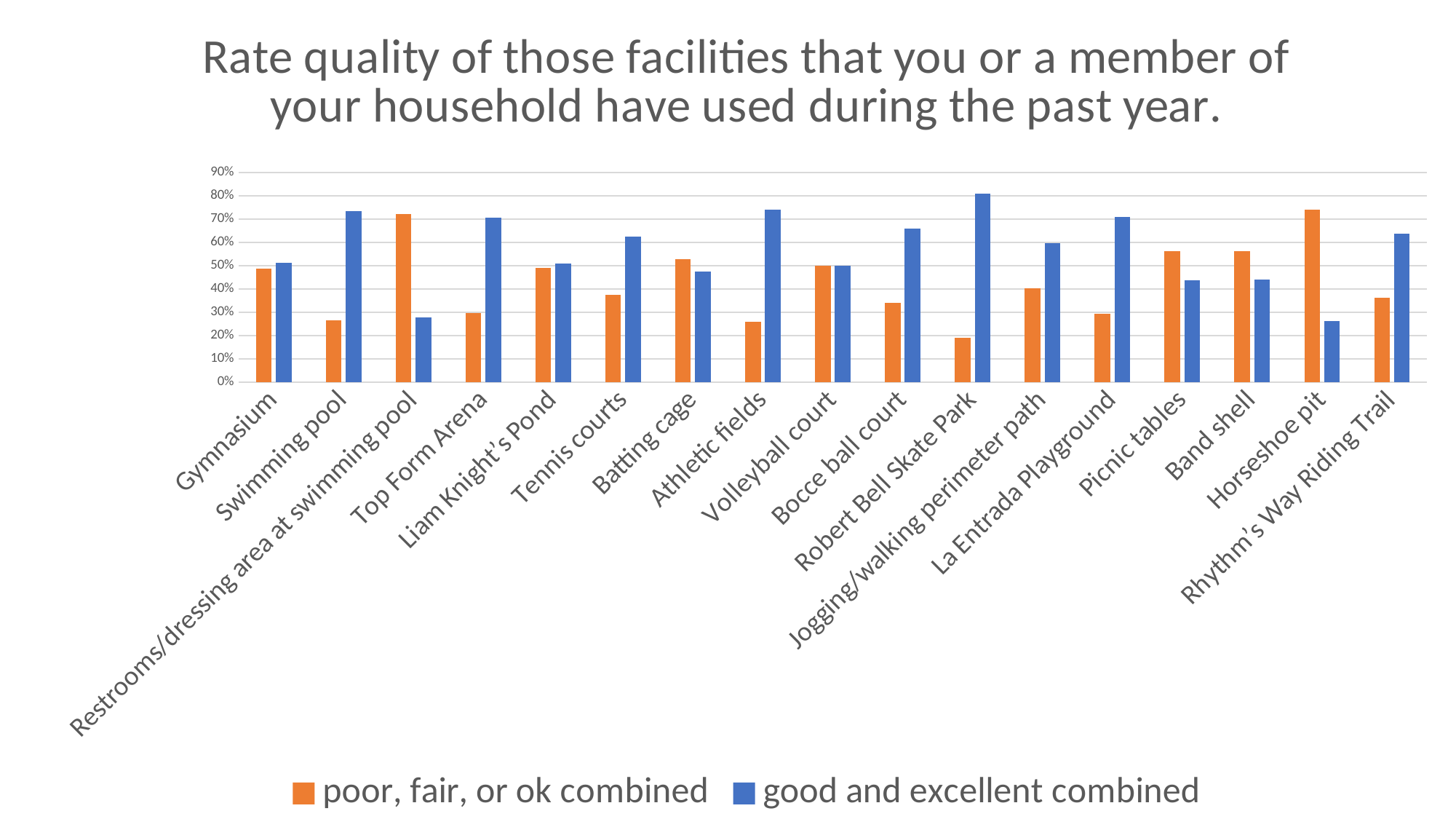
For Swimming pool, which is larger: 'poor, fair, or ok combined' or 'good and excellent combined'? good and excellent combined How many series does the legend list? 2 What kind of chart is shown on the slide? bar chart What colour represents the 'good and excellent combined' series? blue Is the 'good and excellent combined' value for Athletic fields greater or less than 70%? greater Which facility has the lowest value for 'poor, fair, or ok combined'? Robert Bell Skate Park For Horseshoe pit, which is larger: 'poor, fair, or ok combined' or 'good and excellent combined'? poor, fair, or ok combined Which facility has the highest value for 'good and excellent combined'? Robert Bell Skate Park Is the 'poor, fair, or ok combined' value for Tennis courts greater or less than 40%? less How many facilities are listed along the x axis? 17 Is the 'good and excellent combined' value for Horseshoe pit greater or less than 30%? less